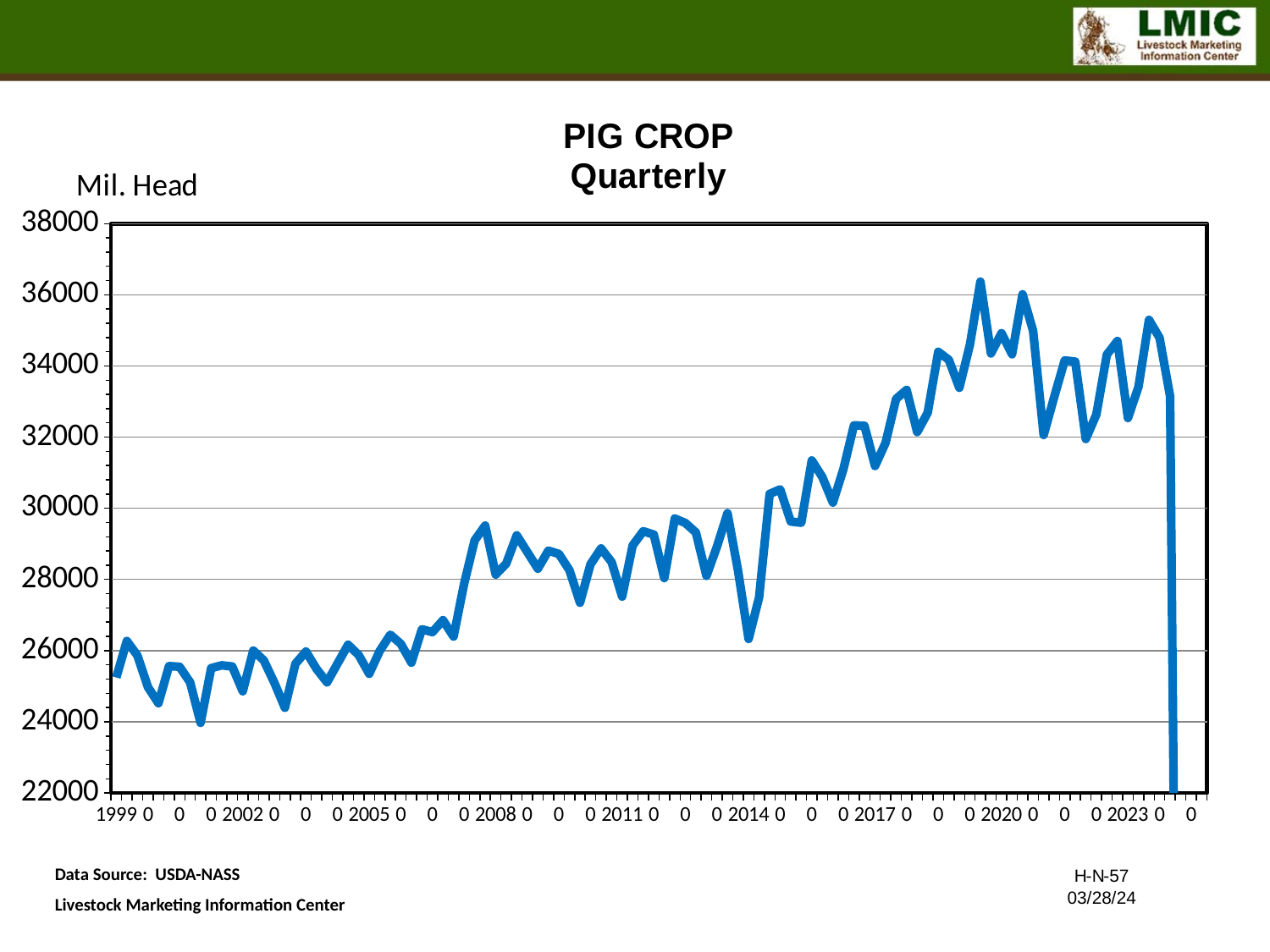
Is the value around 2005 greater or less than 27000? less Is the lowest value around 2001 greater or less than 25000? less Overall, does the pig crop rise or fall from 1999 to 2023? rise Is the value at the start of 1999 greater or less than 26000? less What is the title of the chart? PIG CROP Quarterly How many data series (lines) are plotted on the chart? 1 What is the highest value shown on the y axis? 38000 What kind of chart is shown on the slide? line chart Which period has higher values, around 2020 or around 1999? around 2020 What unit label is shown on the y axis of the chart? Mil. Head